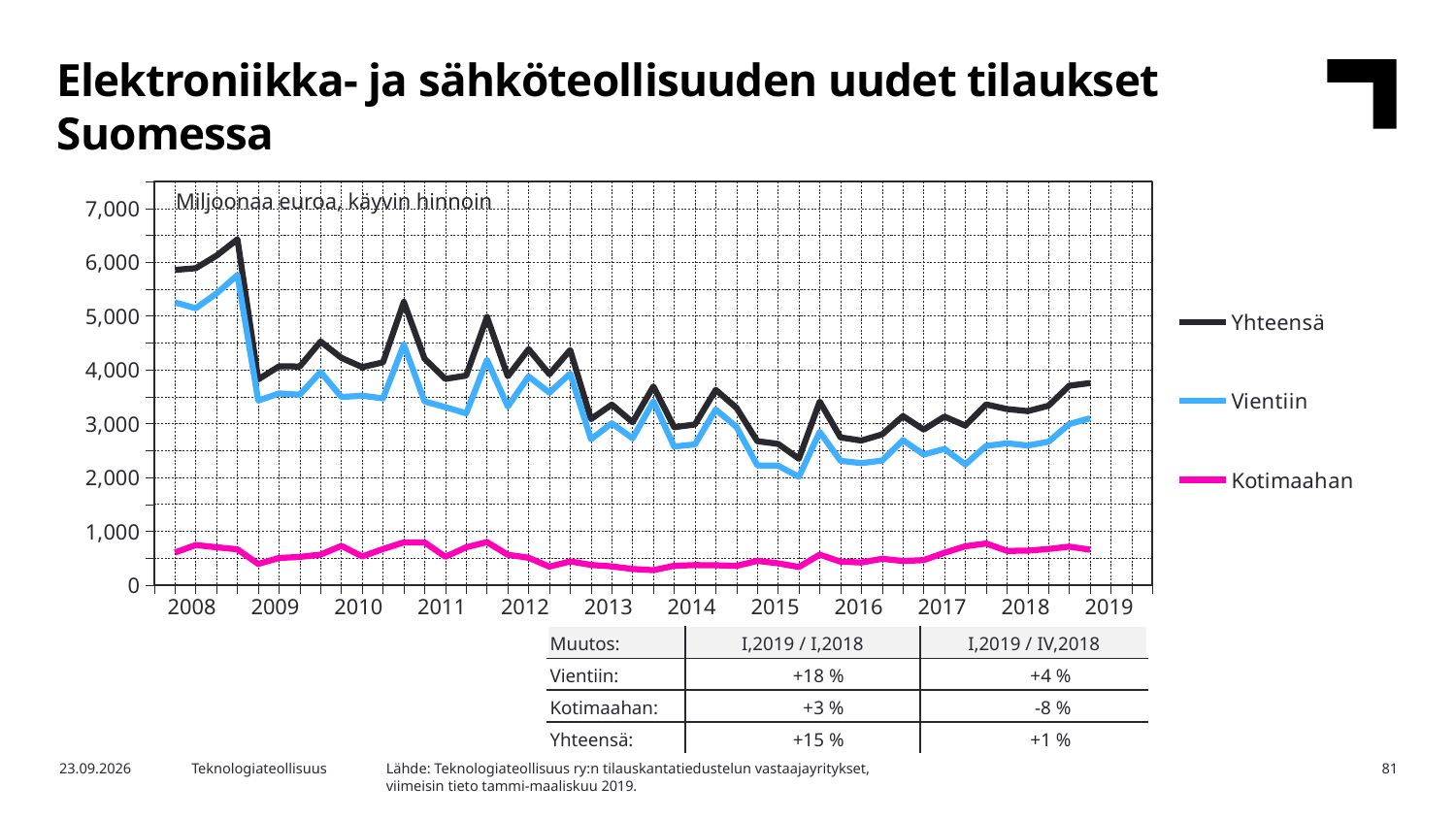
How many year labels are shown on the x axis? 12 How many series does the legend list? 3 Is the value for Yhteensä at the start of 2008 greater or less than 5,000? greater What kind of chart is shown on the slide? line chart Does the Yhteensä line overall rise or fall from 2008 to 2016? fall Which series is plotted with the black line? Yhteensä In 2018, which is larger, Vientiin or Kotimaahan? Vientiin Which series has the highest values throughout the chart? Yhteensä Is the value for Vientiin in 2016 greater or less than 3,000? less Which series has the lowest values throughout the chart? Kotimaahan What unit is stated at the top of the chart area? Miljoonaa euroa, käyvin hinnoin Is the value for Kotimaahan in 2008 greater or less than 1,000? less